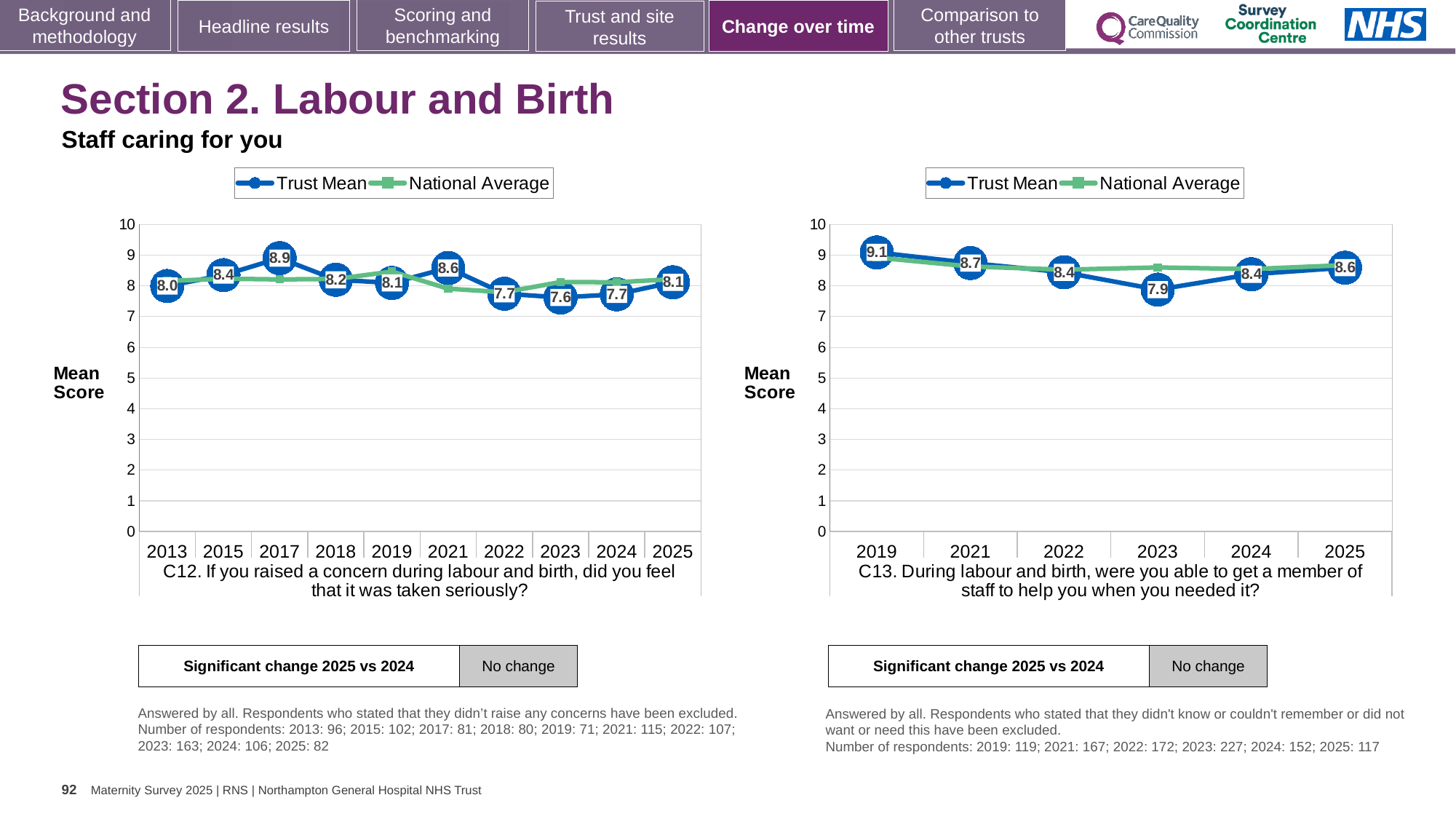
In the C12 chart (left), what is the Trust Mean for 2025? 8.1 In the C12 chart (left), which year has the lowest Trust Mean? 2023 What kind of chart is the C12 chart (left)? Line chart In the C13 chart (right), which year has the lowest Trust Mean? 2023 In the C12 chart (left), which year has the highest Trust Mean? 2017 In the C13 chart (right), what is the Trust Mean for 2019? 9.1 In the C13 chart (right), what is the difference between the Trust Mean for 2019 and the Trust Mean for 2025? 0.5 How many series does the legend of the C13 chart (right) list? 2 In the C13 chart (right), is the Trust Mean for 2021 larger or smaller than the Trust Mean for 2025? larger In the C12 chart (left), what is the Trust Mean for 2017? 8.9 In the C12 chart (left), what is the difference between the Trust Mean for 2017 and the Trust Mean for 2023? 1.3 In the C12 chart (left), how many years are shown on the x axis? 10